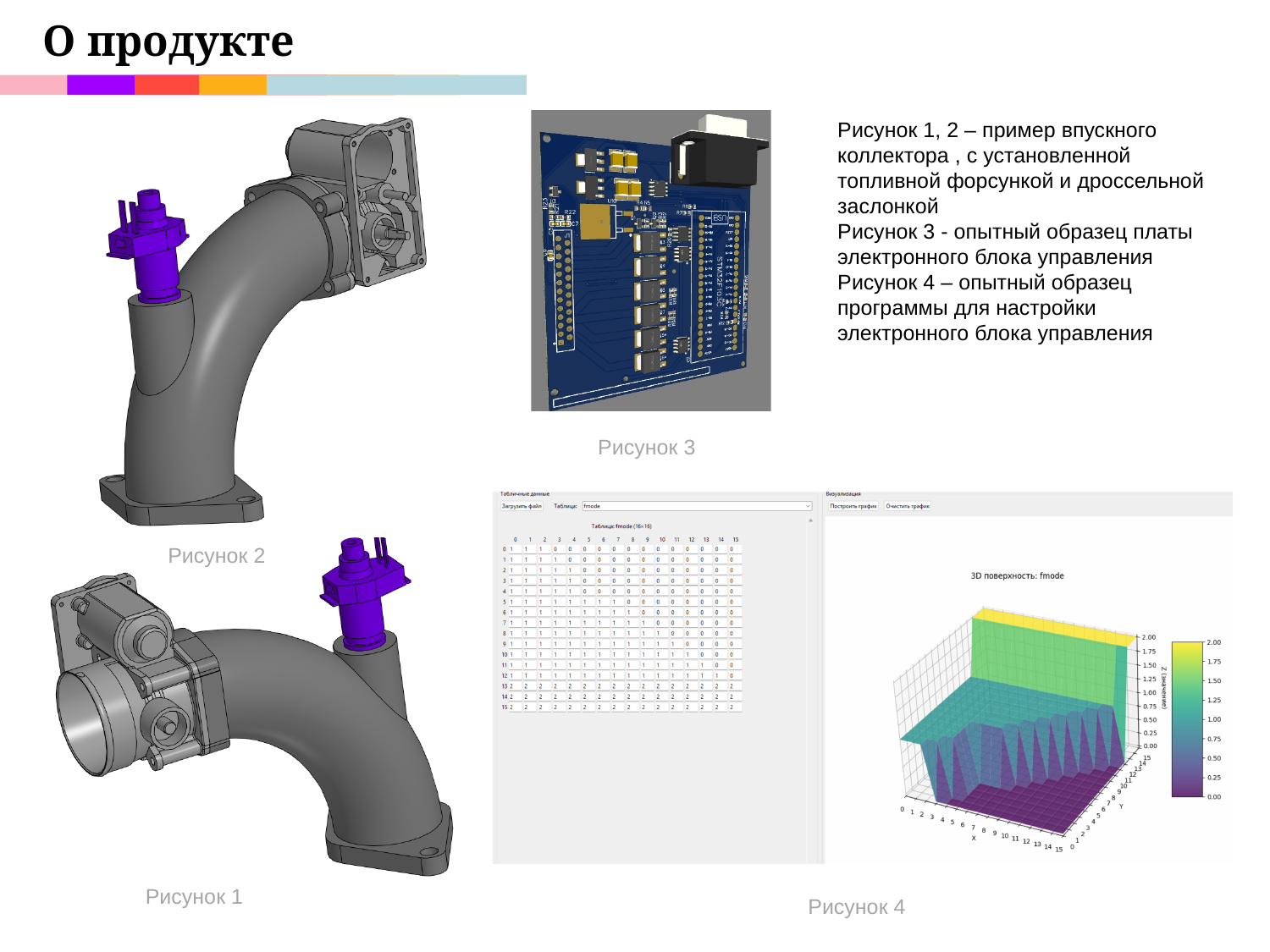
What is the title of the chart in Рисунок 4? 3D поверхность: fmode In Рисунок 4, how many rows does the data table (Таблица: fmode) have, according to its stated size? 16 In the chart in Рисунок 4, what is the largest tick value on the X axis? 15 In the chart in Рисунок 4, what is the label of the vertical (Z) axis? Z (Значение) In the chart in Рисунок 4, what is the highest value shown on the colour bar scale? 2.00 In Рисунок 4, what is the stated size of the table fmode? 16×16 What kind of chart is shown in Рисунок 4? 3D surface plot In the chart in Рисунок 4, what is the lowest value shown on the colour bar scale? 0.00 In the chart in Рисунок 4, what is the largest tick value on the Y axis? 15